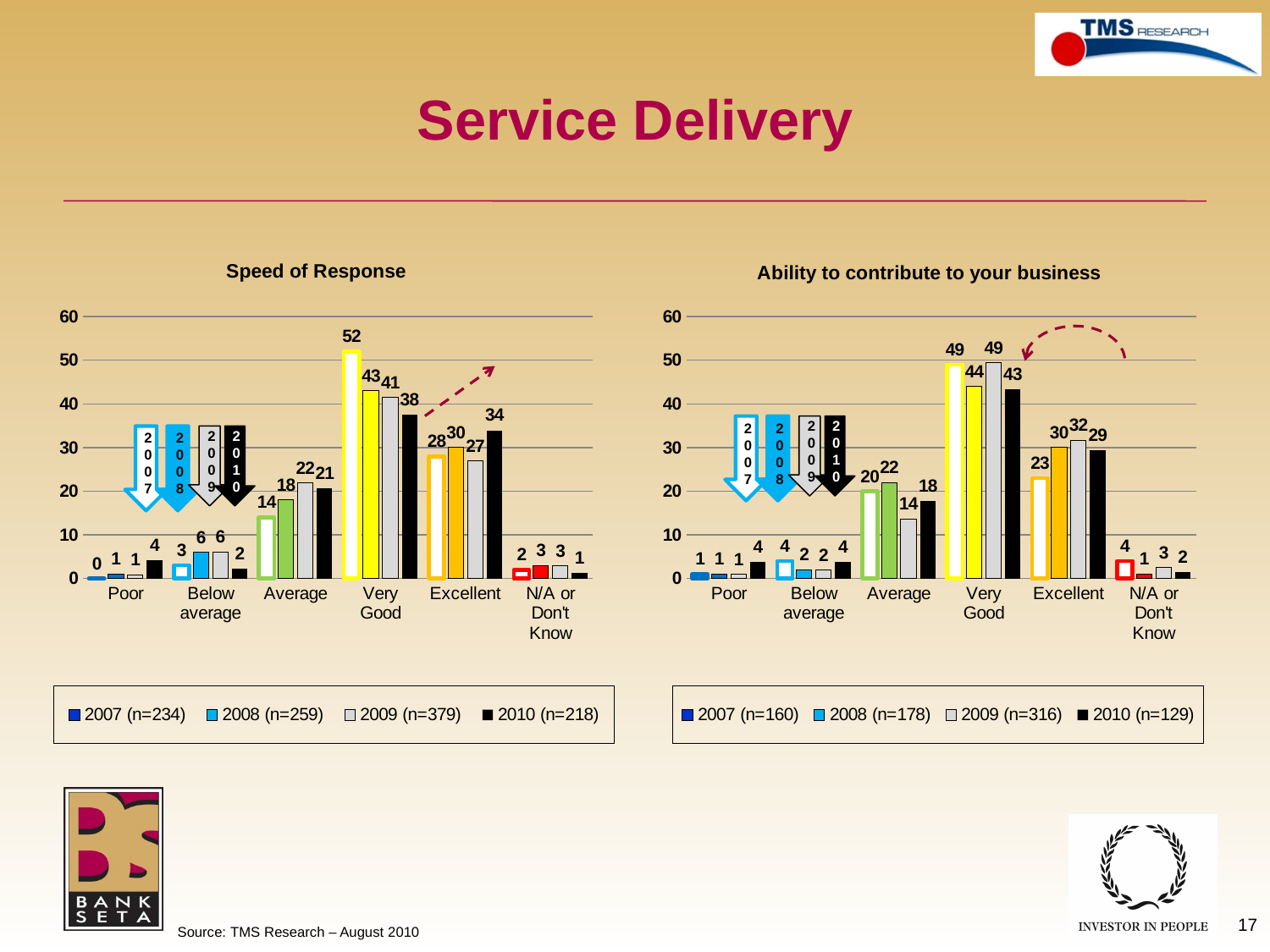
In the Ability to contribute to your business chart, what is the difference between the 2009 and 2010 values for Very Good? 6 In the Speed of Response chart, what is the difference between the 2007 and 2010 values for Very Good? 14 In the Ability to contribute to your business chart, which is larger for Excellent: the 2007 value or the 2010 value? 2010 In the Speed of Response chart, which category has the highest value for 2010? Very Good How many categories are shown on the x axis of the Ability to contribute to your business chart? 6 In the Speed of Response chart, how do the Very Good values change from 2007 to 2010? They fall In the Speed of Response chart, what is the value for Very Good in 2007? 52 In the Ability to contribute to your business chart, what is the value for Average in 2009? 14 In the Ability to contribute to your business chart, what is the value for Excellent in 2009? 32 What type of chart is the Speed of Response chart? Bar chart How many series does the legend of the Speed of Response chart list? 4 In the Speed of Response chart, what is the value for Excellent in 2010? 34